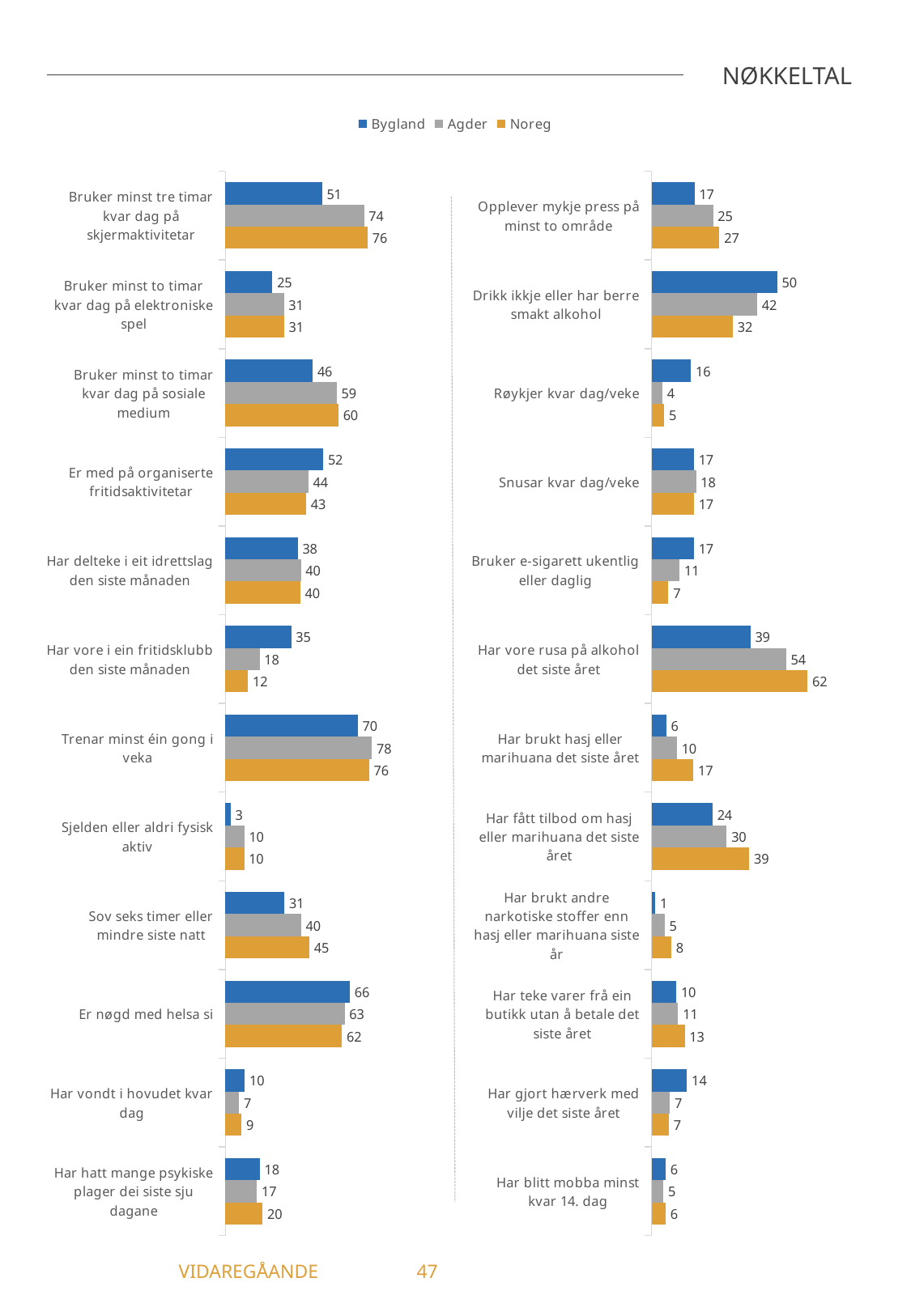
In the right chart, what is the value for Noreg for 'Har vore rusa på alkohol det siste året'? 62 In the right chart, what is the difference between the Noreg and Bygland values for 'Har brukt hasj eller marihuana det siste året'? 11 In the left chart, which category has the lowest Bygland value? Sjelden eller aldri fysisk aktiv Which colour represents Noreg in the legend? Orange In the right chart, which is larger for 'Drikk ikkje eller har berre smakt alkohol': Bygland or Noreg? Bygland In the left chart, what is the value for Bygland for 'Trenar minst éin gong i veka'? 70 In the left chart, which is larger for 'Har vore i ein fritidsklubb den siste månaden': Bygland or Agder? Bygland What kind of chart is the left chart? Bar chart How many series does the legend list? 3 How many categories are shown in the right chart? 12 In the right chart, what is the value for Agder for 'Røykjer kvar dag/veke'? 4